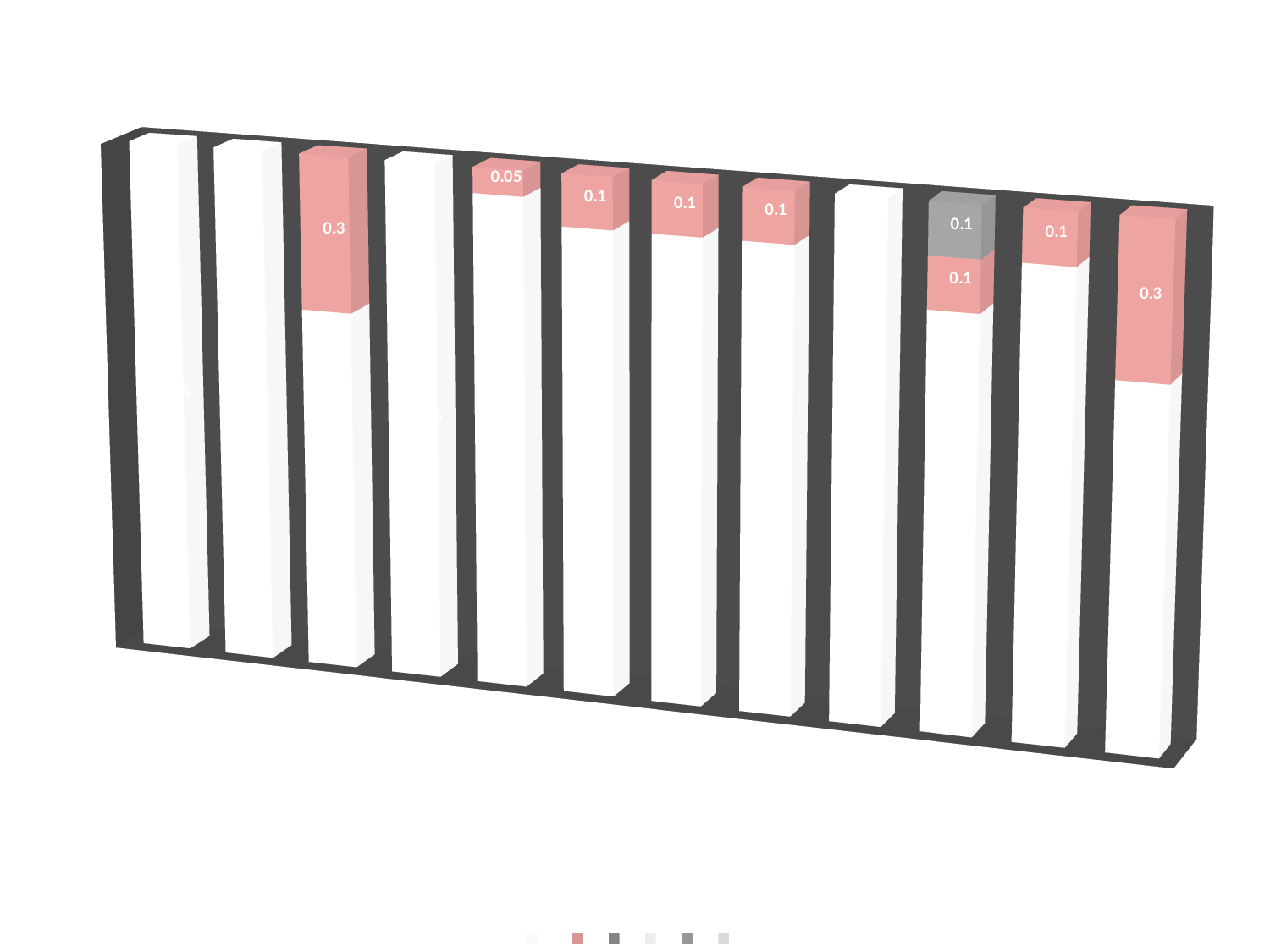
What is the value labelled on the pink segment of the fifth bar from the left? 0.05 What is the difference between the pink segment value on the third bar from the left (0.3) and the pink segment value on the fifth bar from the left (0.05)? 0.25 What is the value labelled on the grey segment of the third bar from the right? 0.1 What is the value labelled on the pink segment of the rightmost bar? 0.3 What kind of chart is shown on the slide? bar chart Which has the larger pink segment value: the third bar from the left or the fifth bar from the left? the third bar from the left How many series does the legend at the bottom of the chart list? 6 What is the value labelled on the pink segment of the third bar from the left? 0.3 What colour is the topmost segment of the third bar from the right? grey What is the value labelled on the pink segment of the sixth bar from the left? 0.1 How many bars are plotted in the chart? 12 How many bars have a labelled pink segment? 8